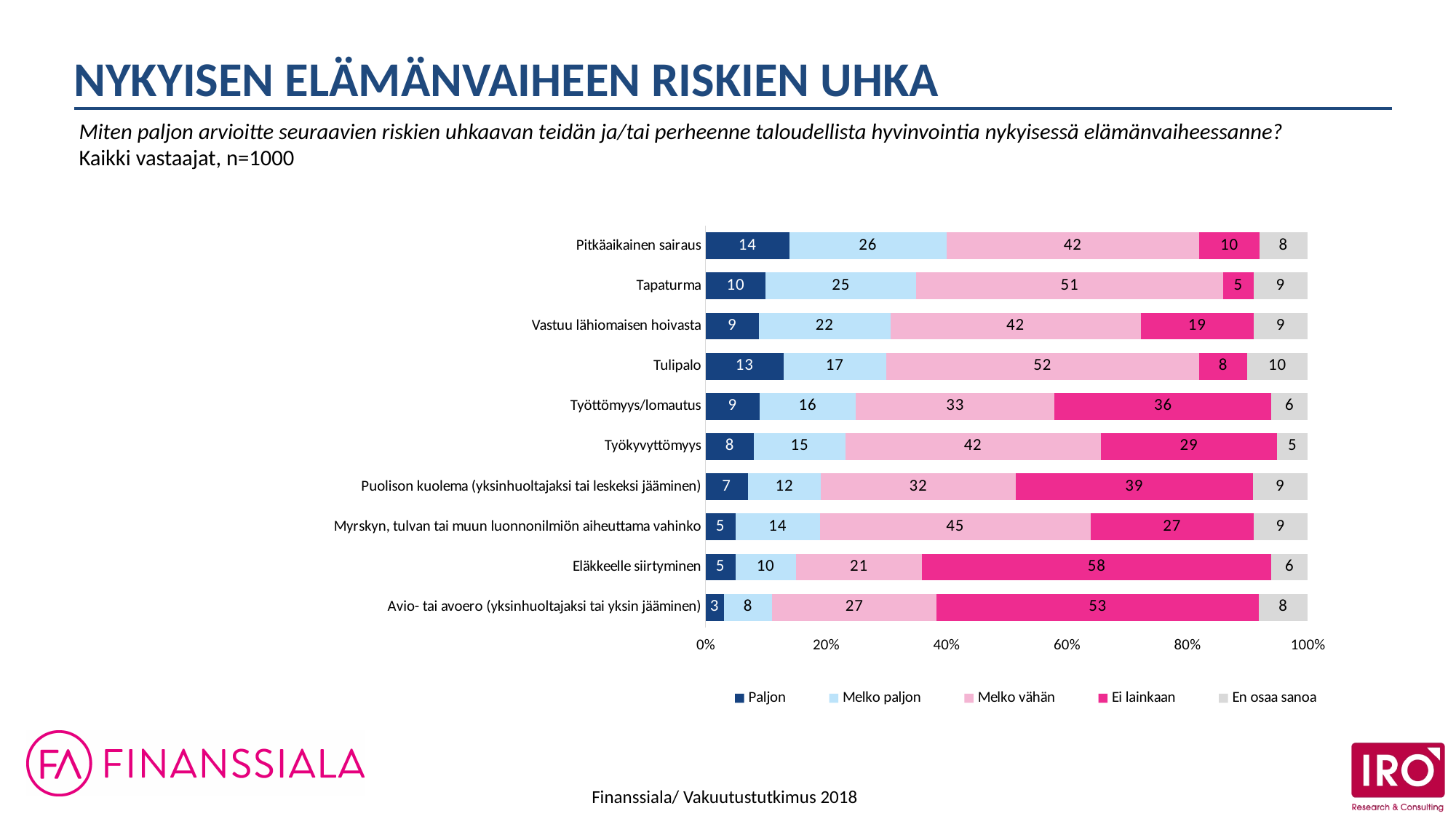
Which category has the highest "Paljon" value? Pitkäaikainen sairaus Which category has the lowest "Paljon" value? Avio- tai avoero (yksinhuoltajaksi tai yksin jääminen) What is the value of "Ei lainkaan" for Eläkkeelle siirtyminen? 58 How many series does the legend list? 5 Which is larger: the "Melko paljon" value for Tapaturma or for Vastuu lähiomaisen hoivasta? Tapaturma What is the difference between the "Ei lainkaan" values for Työttömyys/lomautus and Työkyvyttömyys? 7 What kind of chart is shown on the slide? Stacked bar chart Which category has the highest "Ei lainkaan" value? Eläkkeelle siirtyminen What is the value of "Paljon" for Pitkäaikainen sairaus? 14 How many categories (risks) are shown in the chart? 10 What is the total of the stacked bar for Tapaturma? 100 What is the value of "Melko vähän" for Tulipalo? 52